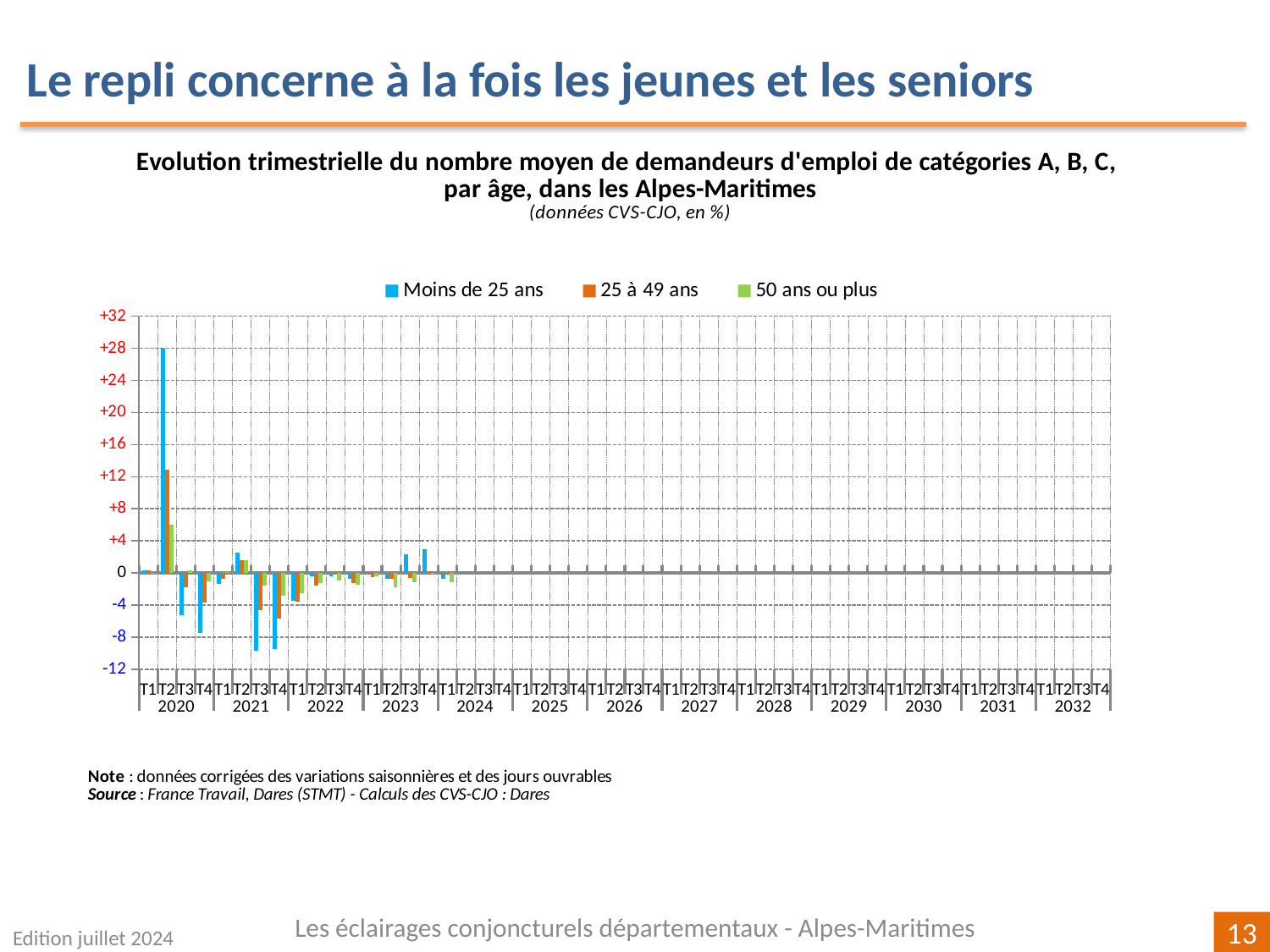
Is the value for 'Moins de 25 ans' in T4 2020 greater or less than -4? less Is the value for 'Moins de 25 ans' in T3 2021 greater or less than -8? less Is the value for '25 à 49 ans' in T2 2020 greater or less than +8? greater In which quarter does the 'Moins de 25 ans' series reach its highest value? T2 2020 In T2 2020, which series has the highest value? Moins de 25 ans What are the three series listed in the legend? Moins de 25 ans, 25 à 49 ans, 50 ans ou plus How many series does the legend list? 3 What kind of chart is shown on the slide? bar chart Which colour represents the series 'Moins de 25 ans'? blue In T2 2020, which is larger: the value for 'Moins de 25 ans' or the value for '25 à 49 ans'? Moins de 25 ans